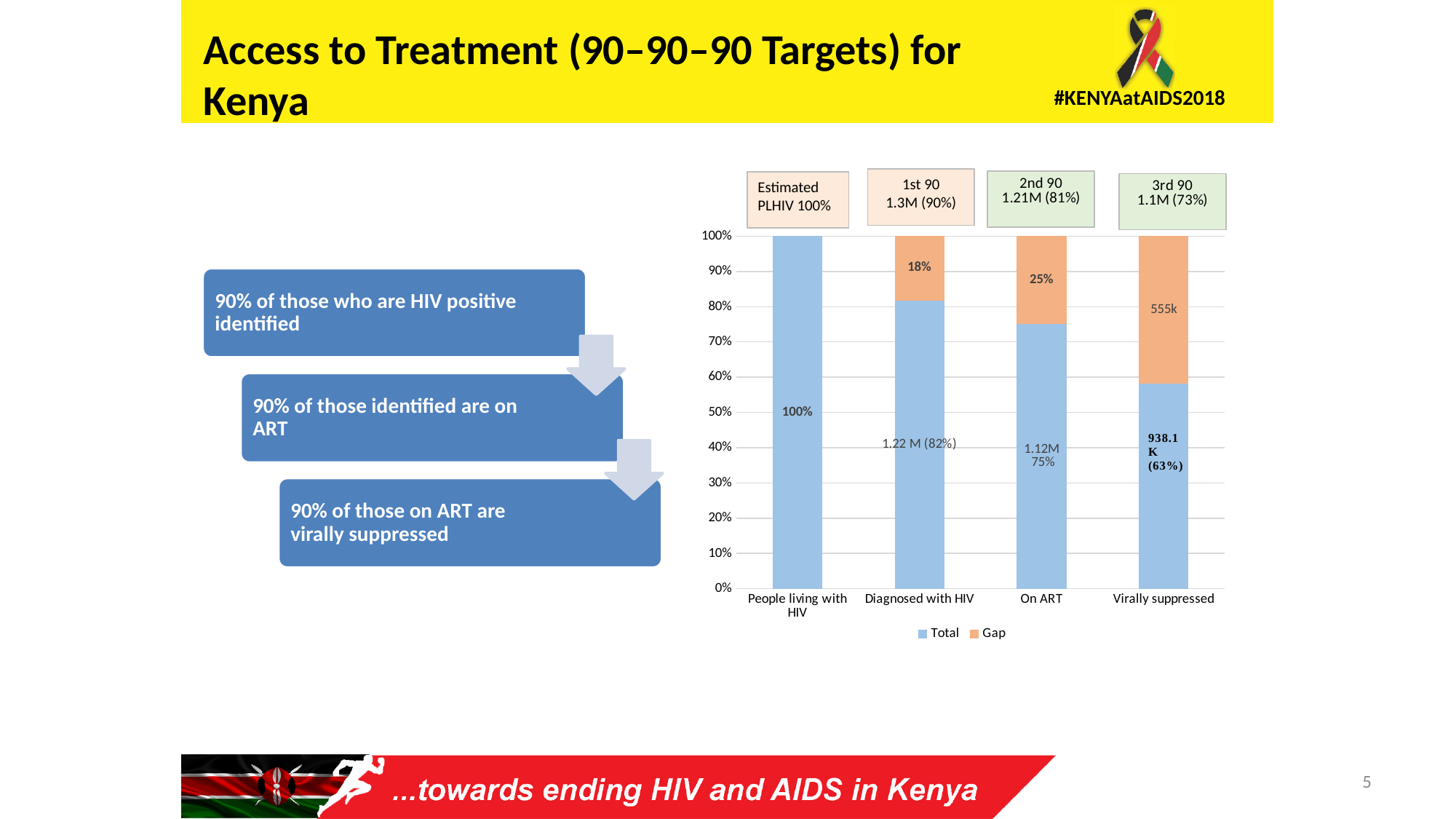
What kind of chart is shown on the slide? stacked bar chart What is the Gap value labelled on the Diagnosed with HIV bar? 18% How many series does the chart legend list? 2 What is the Gap value labelled on the Virally suppressed bar? 555k Is the Total segment for Virally suppressed greater or less than 50%? greater Which category has the largest Gap segment? Virally suppressed What is the Gap value labelled on the On ART bar? 25% Do the Total (blue) segments rise or fall from left to right across the categories? fall How many categories are shown on the x axis of the chart? 4 What is the Total value labelled on the Diagnosed with HIV bar? 1.22 M (82%) What are the two series named in the chart legend? Total and Gap What is the Total value labelled on the Virally suppressed bar? 938.1K (63%)